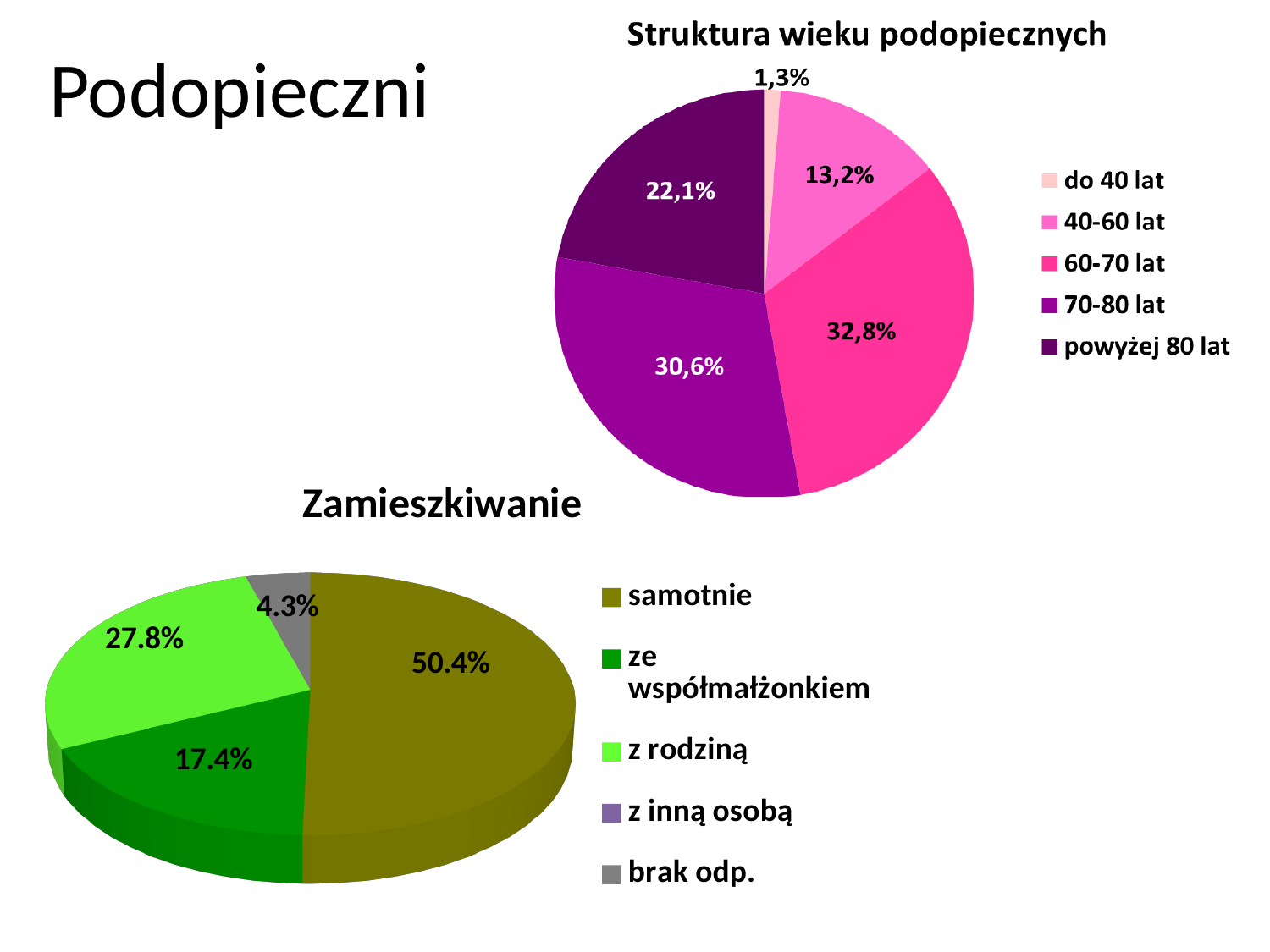
In the 'Zamieszkiwanie' chart, what colour is the 'samotnie' slice? Olive green In the 'Struktura wieku podopiecznych' chart, which age group has the largest share? 60-70 lat In the 'Zamieszkiwanie' chart, what is the difference between the shares of 'samotnie' and 'brak odp.'? 46.1% In the 'Zamieszkiwanie' chart, what share is shown for 'z rodziną'? 27.8% In the 'Zamieszkiwanie' chart, which is larger: 'ze współmałżonkiem' or 'z rodziną'? z rodziną In the 'Struktura wieku podopiecznych' chart, what is the difference between the shares of the 60-70 lat and 70-80 lat groups? 2,2% In the 'Zamieszkiwanie' chart, what share is shown for 'samotnie'? 50.4% What type of chart is 'Zamieszkiwanie'? Pie chart In the 'Struktura wieku podopiecznych' chart, which age group has the smallest share? do 40 lat In the 'Struktura wieku podopiecznych' chart, how many entries does the legend list? 5 In the 'Struktura wieku podopiecznych' chart, what share is shown for the 60-70 lat group? 32,8% In the 'Struktura wieku podopiecznych' chart, what share is shown for the 'powyżej 80 lat' group? 22,1%